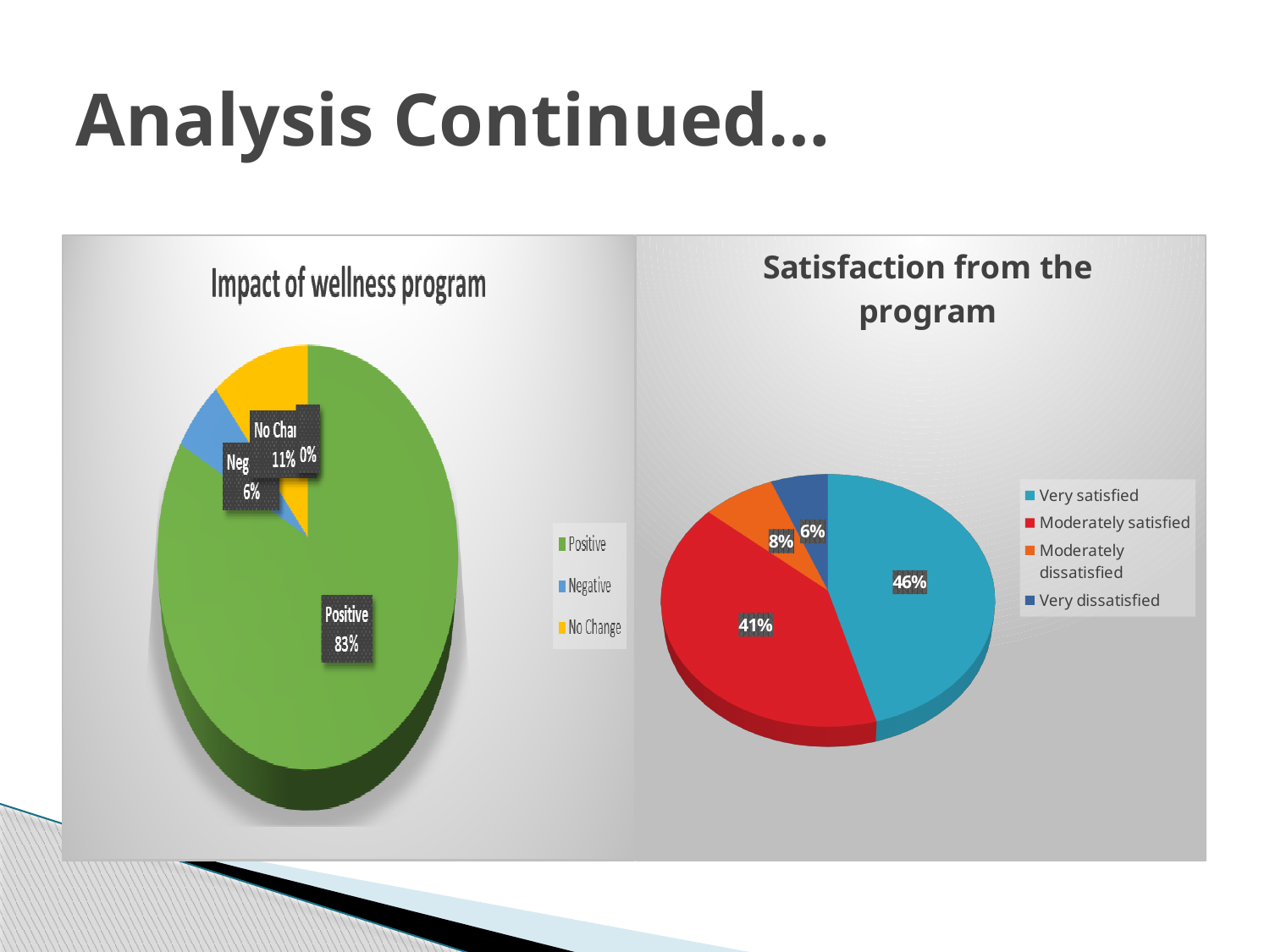
In the 'Satisfaction from the program' chart, what percentage were Very satisfied? 46% In the 'Impact of wellness program' chart, which category has the largest share? Positive In the 'Impact of wellness program' chart, what percentage of responses were Negative? 6% In the 'Satisfaction from the program' chart, what percentage were Moderately satisfied? 41% In the 'Satisfaction from the program' chart, which category has the smallest share? Very dissatisfied In the 'Satisfaction from the program' chart, what percentage were Very dissatisfied? 6% What type of chart is 'Satisfaction from the program'? Pie chart In the 'Satisfaction from the program' chart, which colour represents Moderately dissatisfied? Orange In the 'Impact of wellness program' chart, what percentage of responses were Positive? 83% In the 'Impact of wellness program' chart, how many categories does the legend list? 3 In the 'Impact of wellness program' chart, what percentage of responses reported No Change? 11% In the 'Satisfaction from the program' chart, what is the difference between the Very satisfied and Moderately satisfied shares? 5%